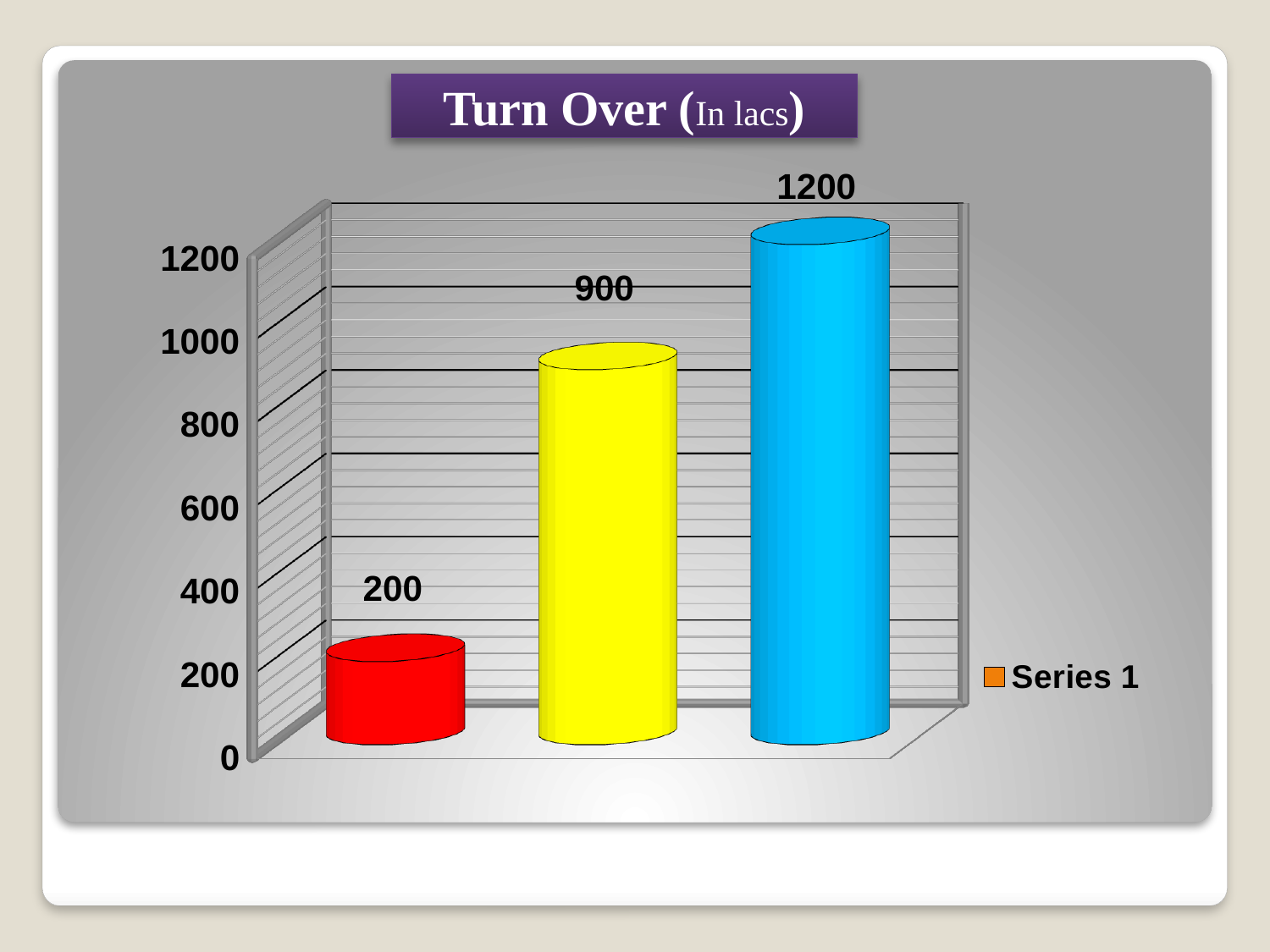
Do the values rise or fall from left to right across the bars? Rise How many series does the legend list? 1 Which bar has the highest value? The blue bar (1200) What is the value of the yellow bar? 900 What kind of chart is shown on the slide? Bar chart What is the value of the red bar? 200 Which bar has the lowest value? The red bar (200) What is the difference between the yellow bar and the red bar? 700 Which is larger, the value of the red bar or the value of the yellow bar? The yellow bar How many bars are plotted in the chart? 3 What is the value of the blue bar? 1200 What is the difference between the blue bar and the yellow bar? 300